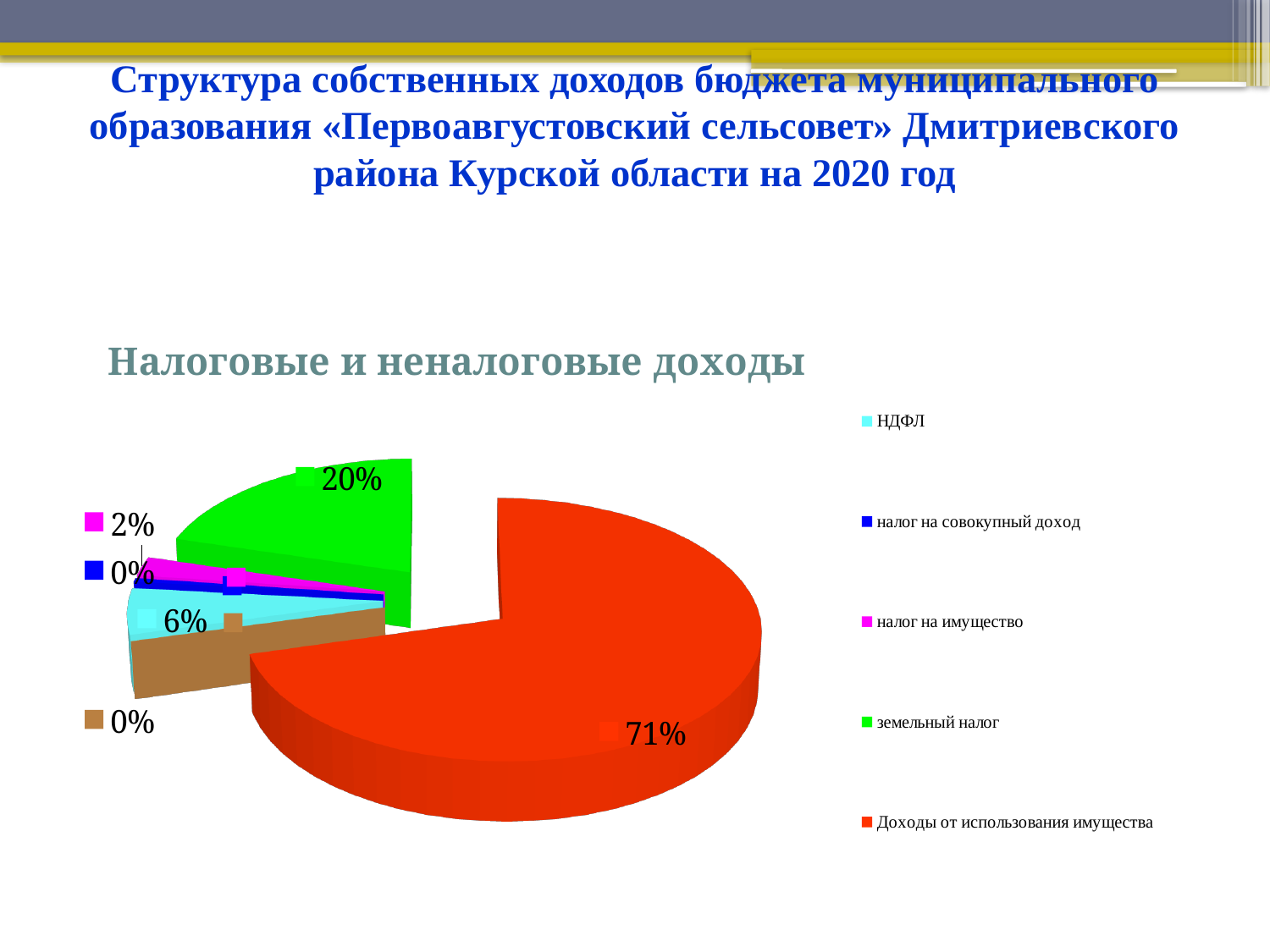
What share of the pie is НДФЛ? 6% What share of the pie is земельный налог? 20% What is the title of the chart? Налоговые и неналоговые доходы What type of chart is shown on the slide? pie chart What is the difference in percentage points between Доходы от использования имущества and земельный налог? 51 Which category has the largest share of the pie? Доходы от использования имущества What colour is the slice for земельный налог? green What share of the pie is Доходы от использования имущества? 71% Which has a larger share, земельный налог or НДФЛ? земельный налог How many entries does the legend list? 5 What share of the pie is налог на имущество? 2% What share of the pie is налог на совокупный доход? 0%